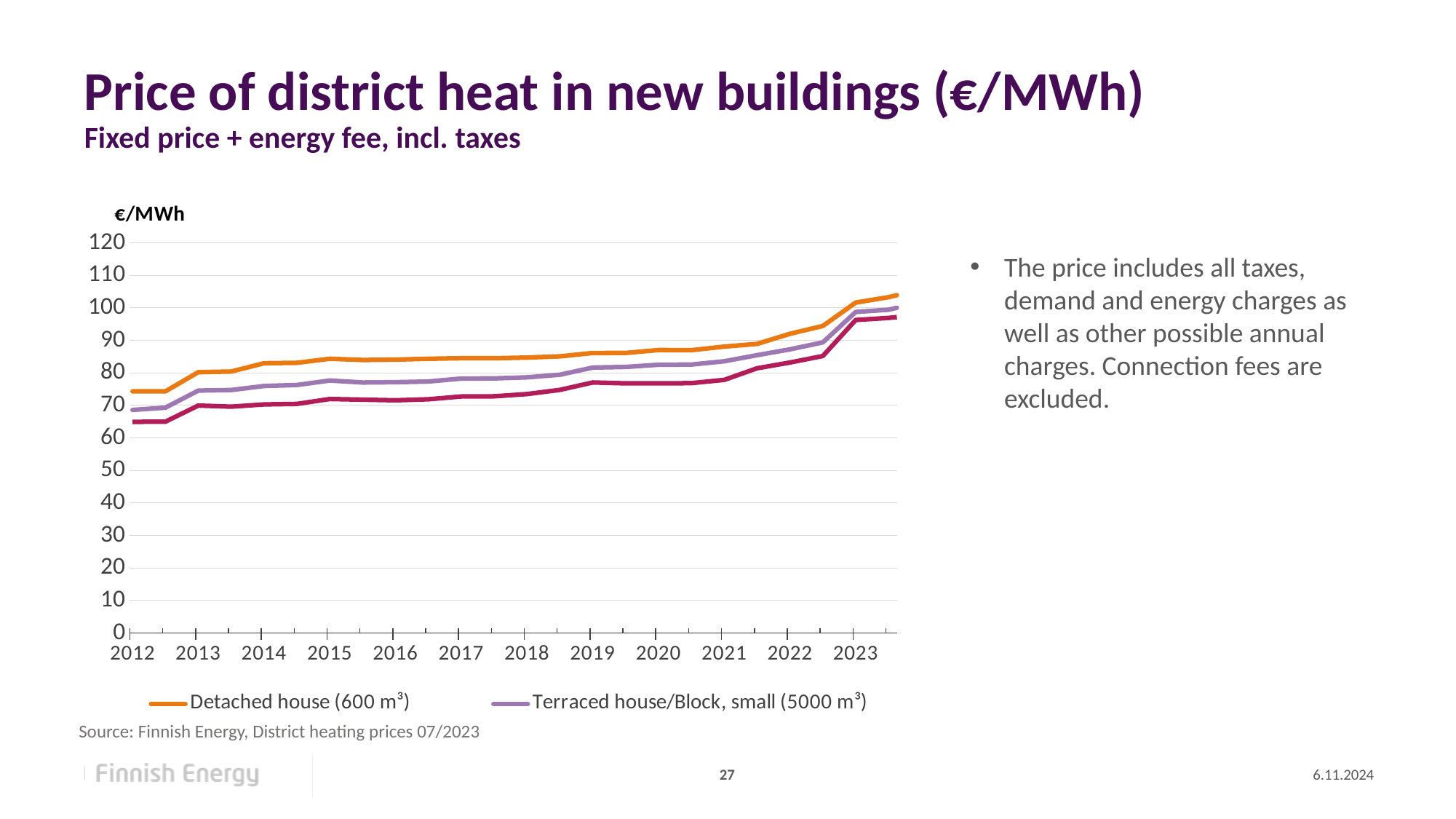
What kind of chart is shown on the slide? line chart Is the value for Terraced house/Block, small (5000 m³) in 2012 greater or less than 60? greater In 2023, which series has the higher value: Detached house (600 m³) or Terraced house/Block, small (5000 m³)? Detached house (600 m³) In 2012, which series has the higher value: Detached house (600 m³) or Terraced house/Block, small (5000 m³)? Detached house (600 m³) Is the value for Detached house (600 m³) in 2012 greater or less than 80? less Does the Detached house (600 m³) line rise or fall from 2012 to 2023? rise What unit is shown on the y axis of the chart? €/MWh How many series does the chart legend list? 2 Is the value for Detached house (600 m³) in 2023 greater or less than 100? greater How many years are labelled on the x axis of the chart? 12